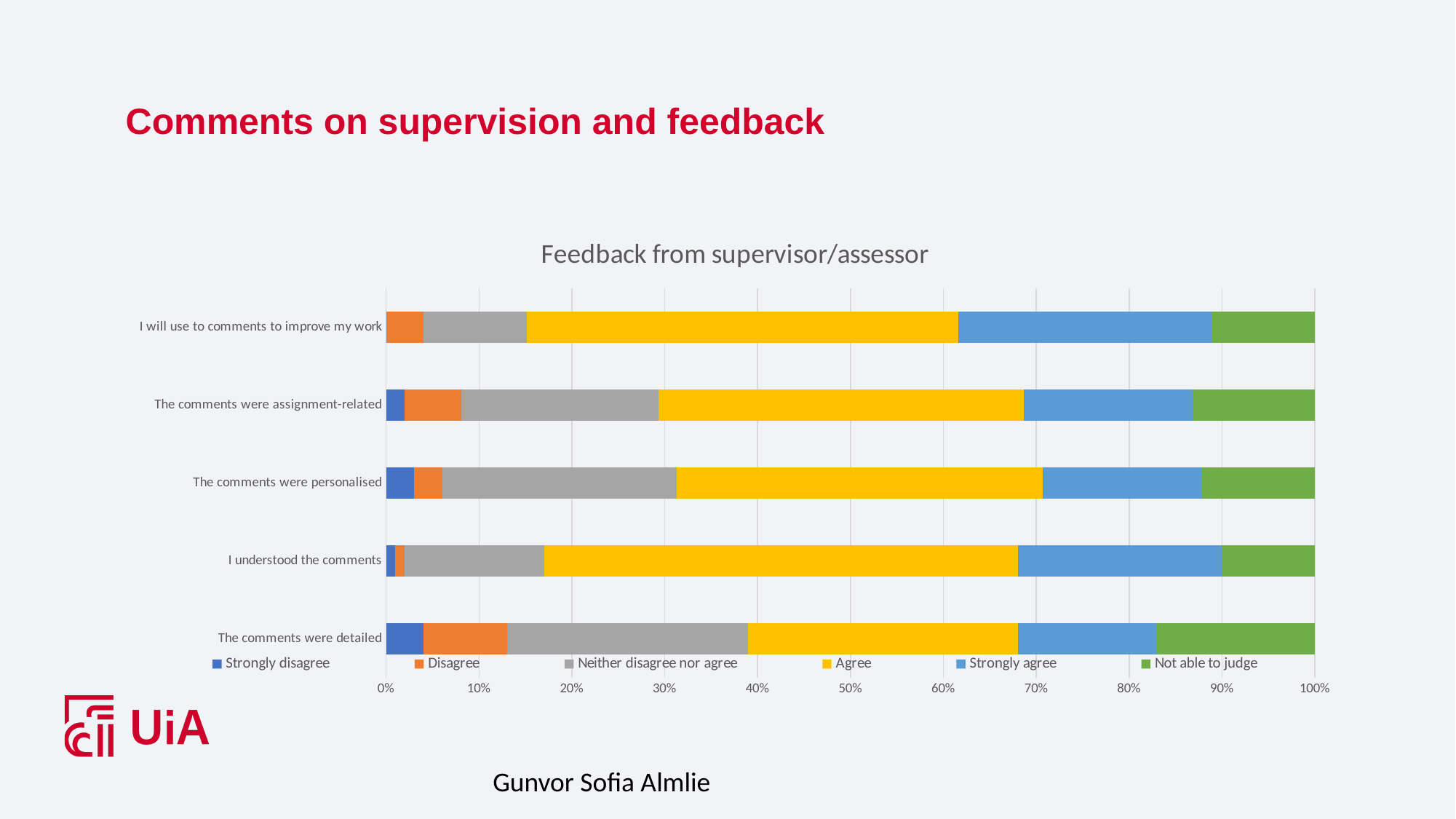
What is the title of the chart? Feedback from supervisor/assessor How many statements (categories) are plotted in the chart? 5 Which statement has the smallest 'Agree' segment? The comments were detailed How many series does the legend list? 6 Which legend entry is shown in yellow? Agree Is the 'Neither disagree nor agree' share for 'The comments were detailed' greater or less than 20%? greater What type of chart is shown on the slide? Bar chart Is the 'Agree' share for 'I understood the comments' greater or less than 40%? greater Which statement has no 'Strongly disagree' segment? I will use to comments to improve my work Which statement has the largest 'Disagree' segment? The comments were detailed Which statement has the largest 'Strongly agree' segment? I will use to comments to improve my work Which statement has the largest 'Not able to judge' segment? The comments were detailed